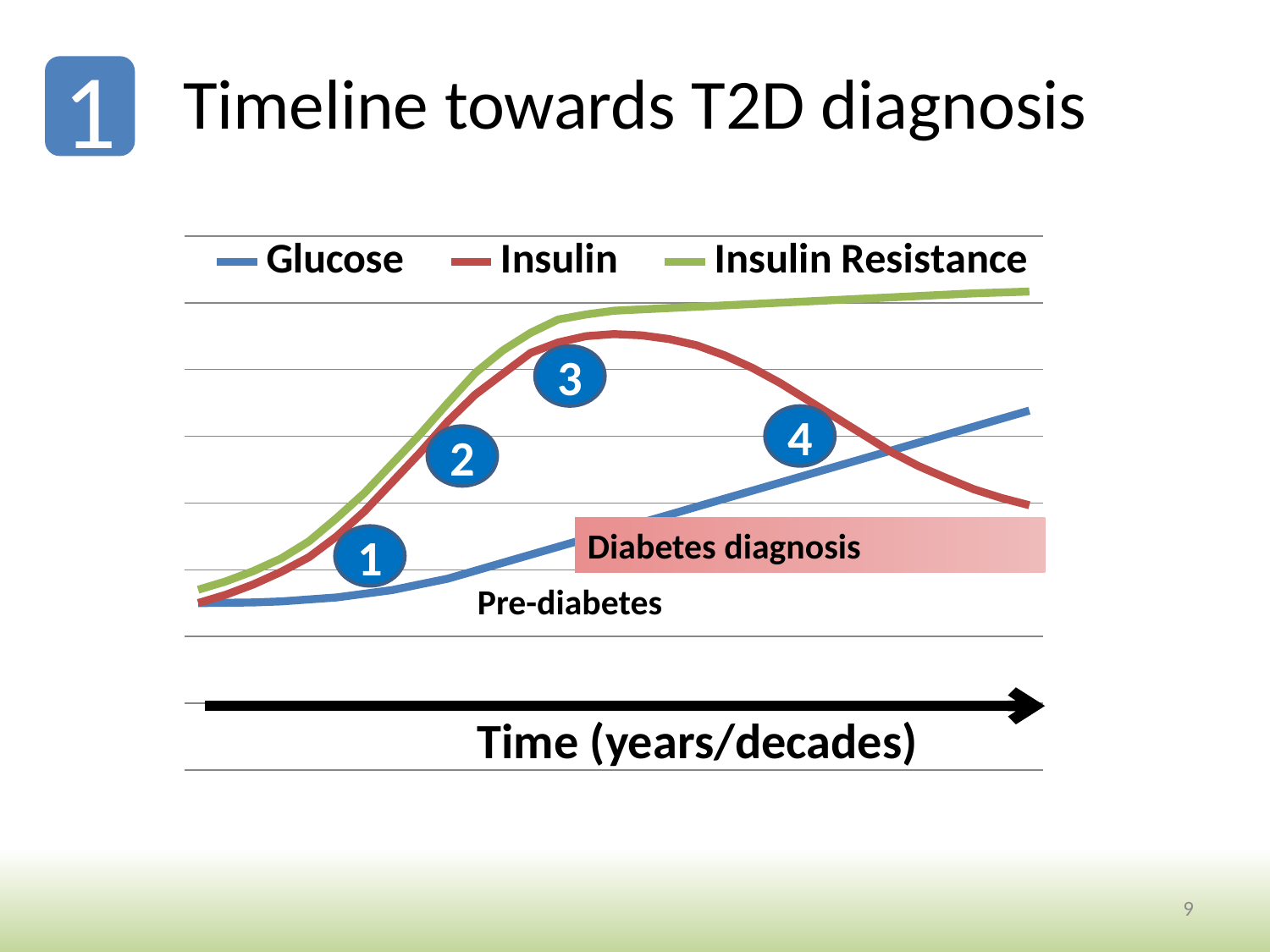
At the right end of the chart, which is higher: Glucose or Insulin? Glucose How does the Insulin line change along the x axis? rises then falls Which series reaches a peak and then declines? Insulin What are the three series named in the chart's legend? Glucose, Insulin, Insulin Resistance Which series is highest at the right end of the chart? Insulin Resistance How many series does the chart's legend list? 3 What is the label on the chart's x axis? Time (years/decades) What kind of chart is shown on the slide? line chart Does the Insulin Resistance line rise or fall along the x axis? rises Which series is lowest at the right end of the chart? Insulin How many numbered circle markers are placed on the chart? 4